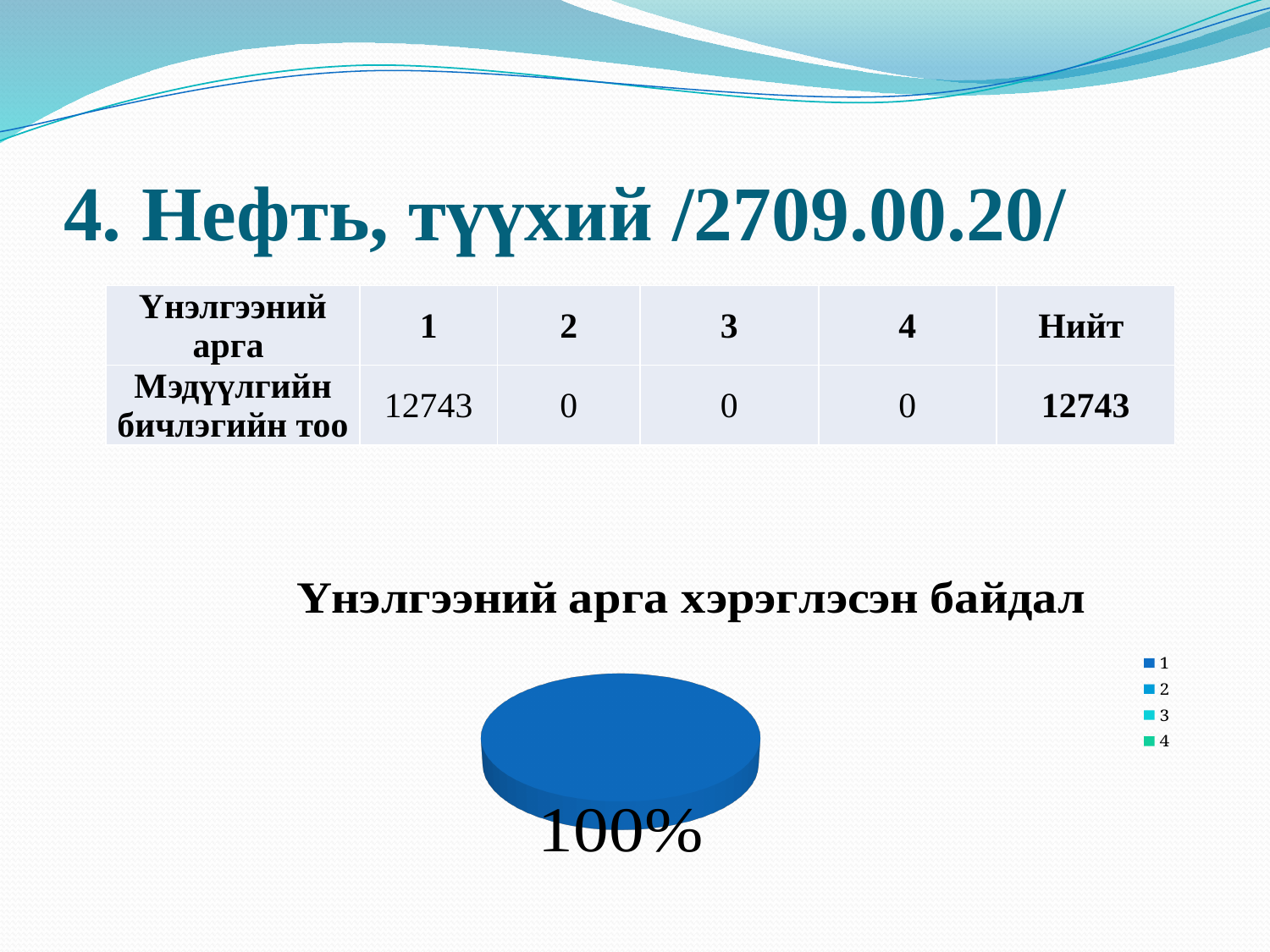
What kind of chart is shown on the slide? pie chart How many entries does the legend of the pie chart list? 4 Which category has the largest slice in the pie chart? 1 Is the share of category 1 in the pie chart greater or less than 50%? greater What share of the pie does the slice for category 1 take? 100% Which legend entries are listed for the pie chart? 1, 2, 3, 4 What percentage label is printed on the pie chart? 100% What is the title of the pie chart? Үнэлгээний арга хэрэглэсэн байдал How many visible slices does the pie chart have? 1